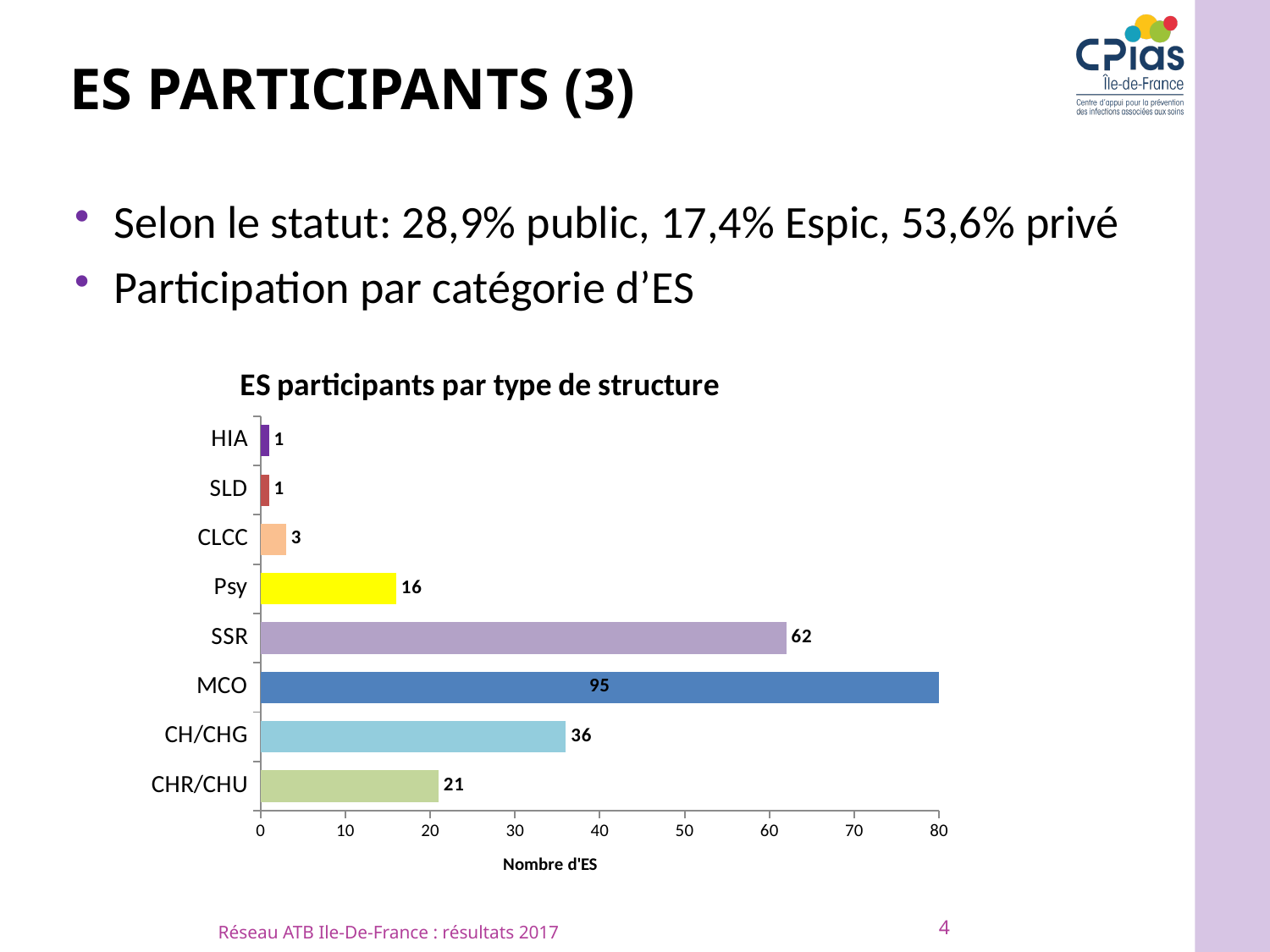
What is the value for SSR? 62 What is the value for MCO in the chart 'ES participants par type de structure'? 95 What is the value for CH/CHG? 36 What is the difference between the values for CH/CHG and CHR/CHU? 15 What is the title of the chart's horizontal axis? Nombre d'ES What is the difference between the values for MCO and SSR? 33 What kind of chart is shown on the slide? Bar chart Which is larger, the value for SSR or the value for CH/CHG? SSR Which category has the highest value? MCO How many categories are shown in the chart? 8 Which category has the lowest value, CLCC or Psy? CLCC What is the value for Psy? 16